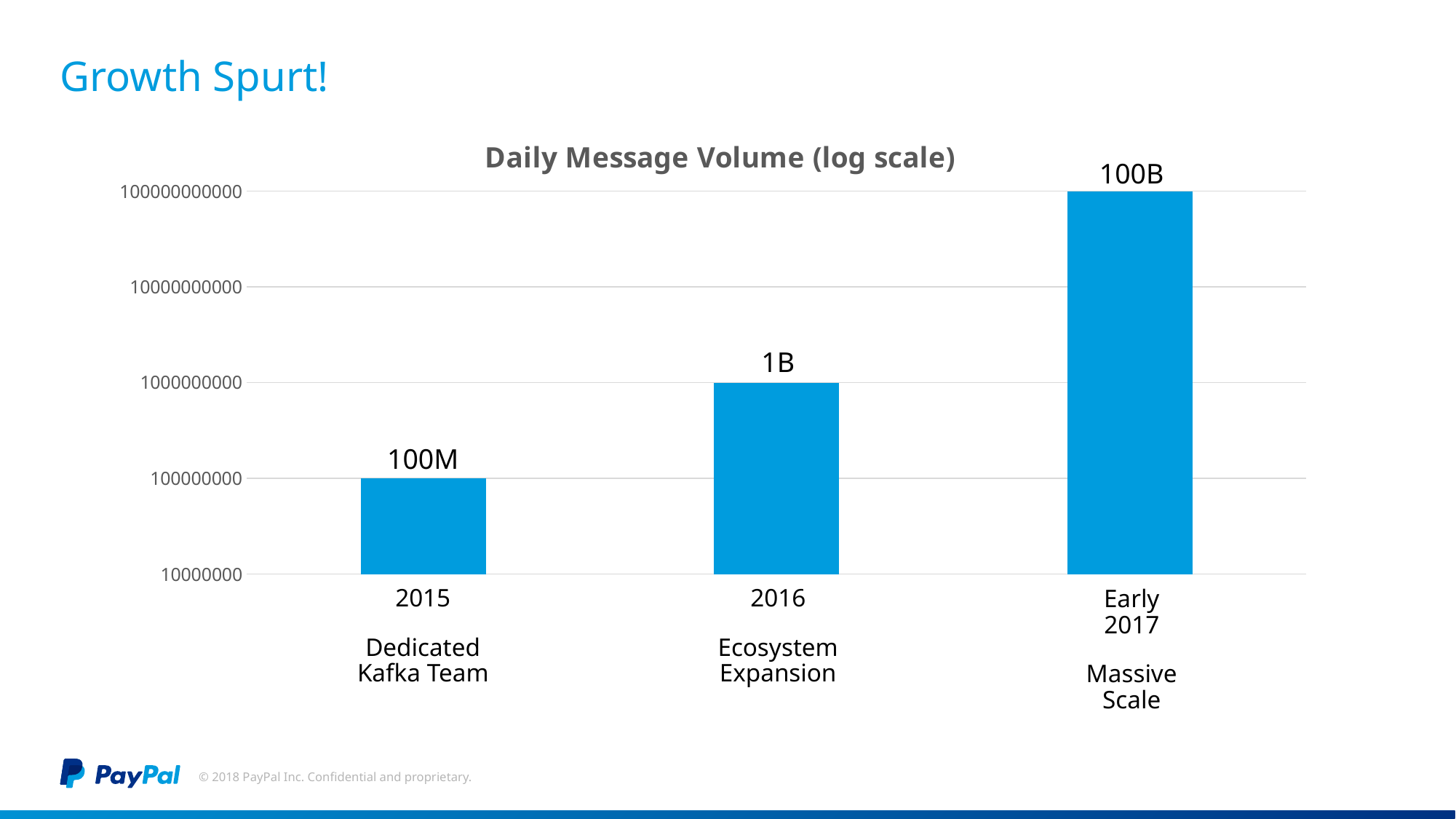
What kind of chart is shown on the slide? Bar chart What is the daily message volume shown for Early 2017? 100B What is the daily message volume shown for 2016? 1B Which category has the highest daily message volume? Early 2017 Is the value for 2016 greater or less than 10000000000? less Do the values rise or fall from 2015 to Early 2017? Rise What is the daily message volume shown for 2015? 100M Which is larger, the daily message volume for 2016 or for 2015? 2016 Which category has the lowest daily message volume? 2015 Is the value for Early 2017 greater or less than 10000000000? greater How many bars are plotted in the chart? 3 What is the title of the chart? Daily Message Volume (log scale)